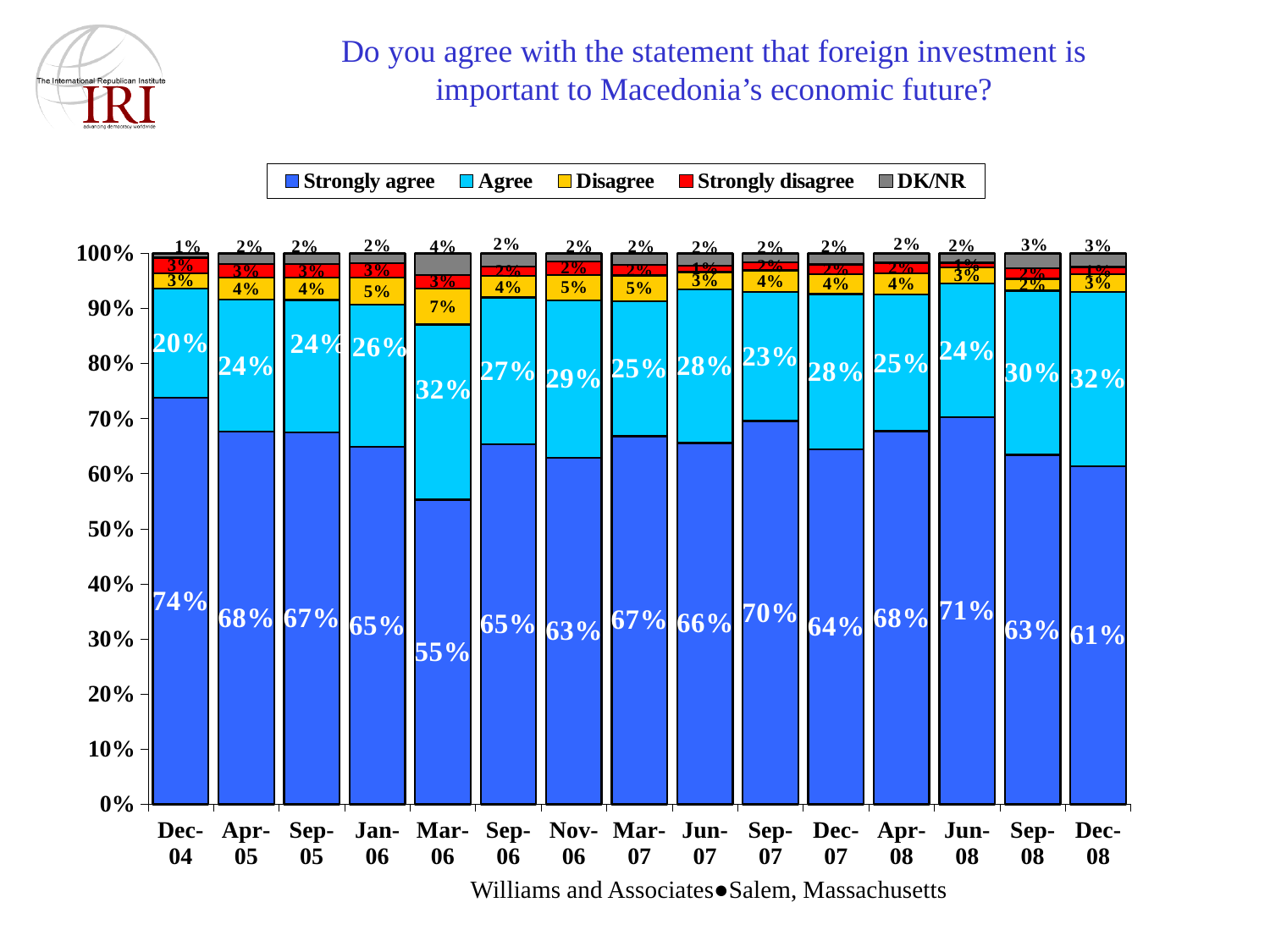
What is the 'Agree' value for Mar-06? 32% What is the 'DK/NR' value for Sep-08? 3% Which series is shown in red in the legend? Strongly disagree How many series does the legend list? 5 What percentage of respondents said 'Strongly agree' in Dec-04? 74% What kind of chart is shown on the slide? Stacked bar chart In which survey period was the 'Strongly agree' share highest? Dec-04 In which survey period was the 'Strongly agree' share lowest? Mar-06 How many survey periods are shown on the x axis? 15 What is the 'Disagree' value for Mar-06? 7% What is the difference between the 'Strongly agree' values for Dec-04 and Mar-06? 19% Which is larger, the 'Strongly agree' value for Jun-08 or for Dec-08? Jun-08